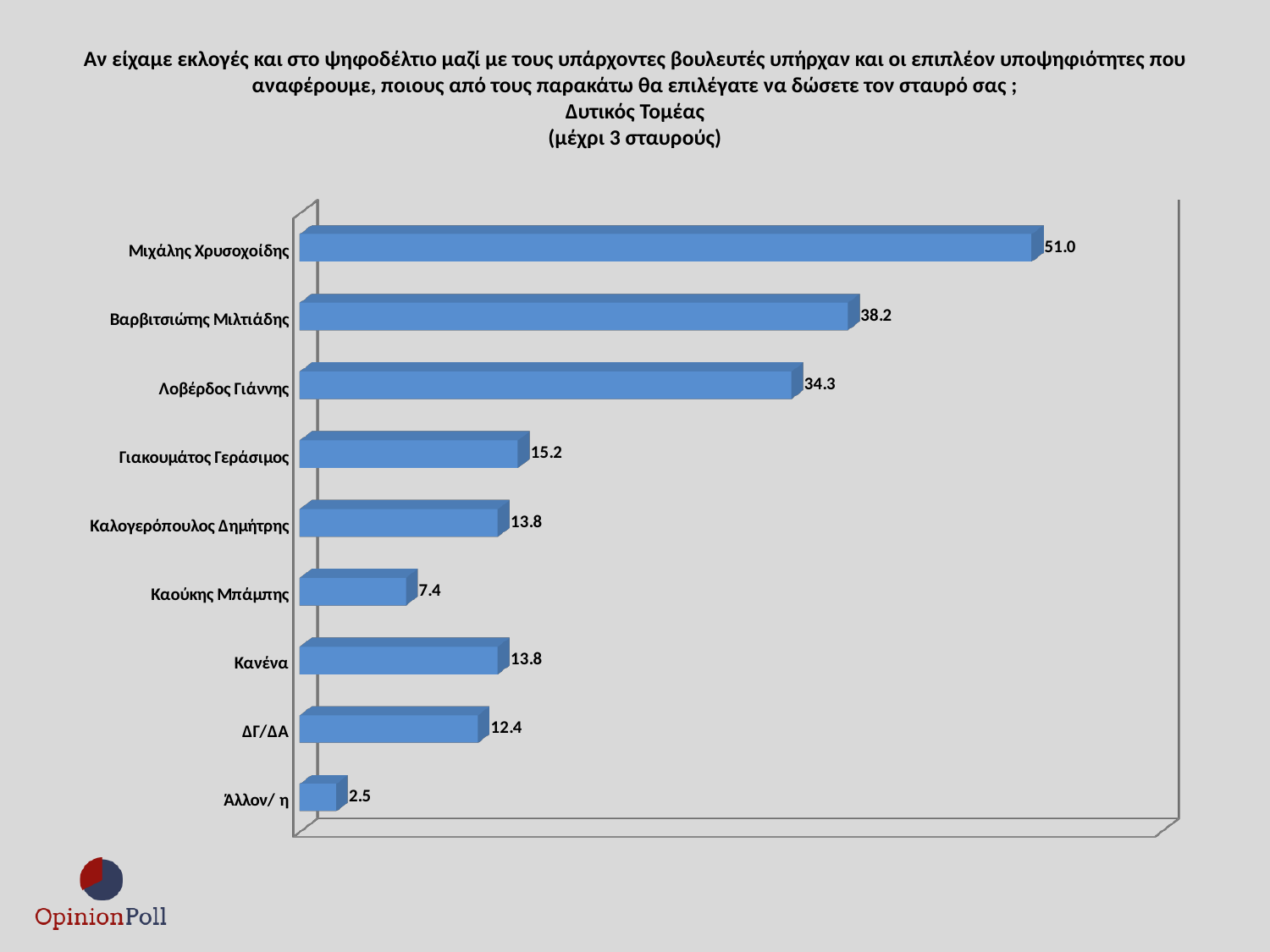
What is the difference between the values for Μιχάλης Χρυσοχοΐδης and Βαρβιτσιώτης Μιλτιάδης? 12.8 Which is larger, the value for Λοβέρδος Γιάννης or the value for Γιακουμάτος Γεράσιμος? Λοβέρδος Γιάννης How many categories are shown in the chart? 9 What is the value for Καούκης Μπάμπης? 7.4 What is the value for Μιχάλης Χρυσοχοΐδης? 51.0 What is the difference between the values for Γιακουμάτος Γεράσιμος and Καλογερόπουλος Δημήτρης? 1.4 What is the value for Λοβέρδος Γιάννης? 34.3 What kind of chart is shown on the slide? Bar chart Which region does the chart's title say the results refer to? Δυτικός Τομέας Which category has the highest value? Μιχάλης Χρυσοχοΐδης What is the value for ΔΓ/ΔΑ? 12.4 Which category has the lowest value? Άλλον/ η